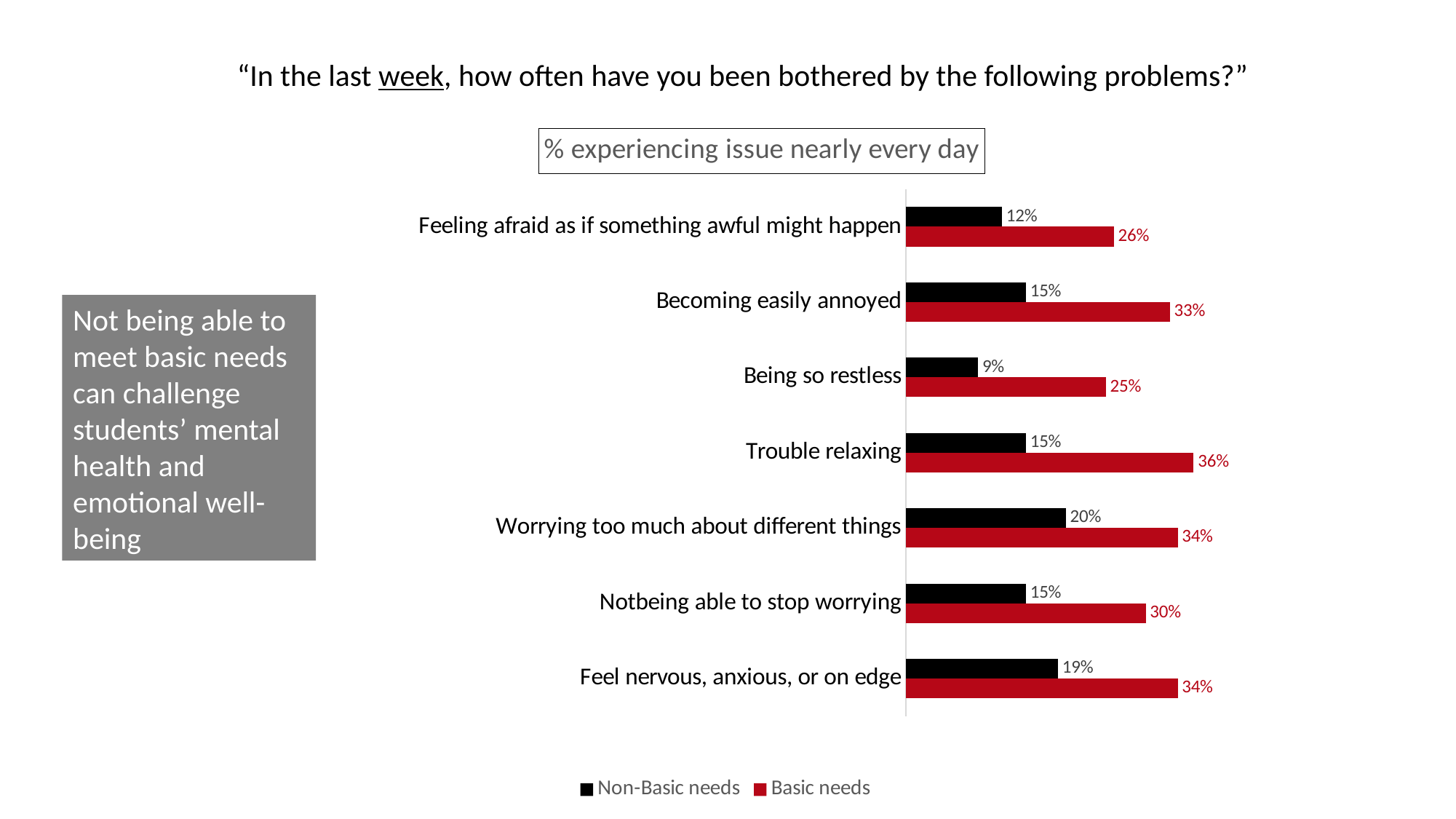
What is the value for Basic needs for "Feeling afraid as if something awful might happen"? 26% How many series does the legend list? 2 What is the value for Non-Basic needs for "Being so restless"? 9% What kind of chart is shown on the slide? Bar chart What is the value for Non-Basic needs for "Worrying too much about different things"? 20% Which category has the lowest Non-Basic needs value? Being so restless Which is larger for "Becoming easily annoyed": the Basic needs value or the Non-Basic needs value? Basic needs Which category has the highest Basic needs value? Trouble relaxing What is the difference between the Basic needs and Non-Basic needs values for "Trouble relaxing"? 21% What colour are the Basic needs bars? Red What is the value for Basic needs for "Trouble relaxing"? 36% How many categories are shown on the chart? 7